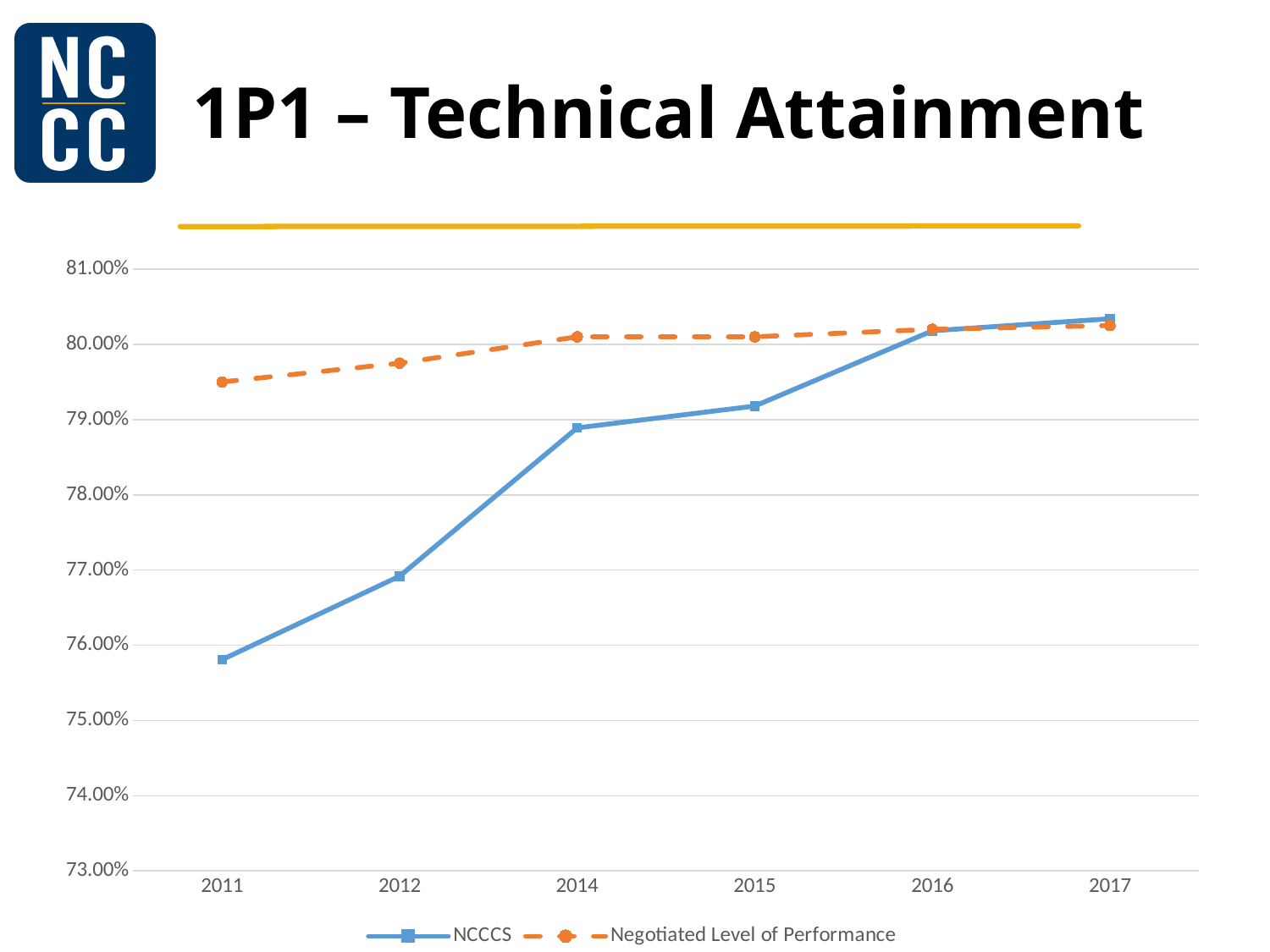
In which year is the Negotiated Level of Performance value lowest? 2011 Is the NCCCS value for 2011 greater or less than 77.00%? less What kind of chart is shown on the slide? line chart How many years are shown on the x axis? 6 Does the NCCCS series rise or fall from 2011 to 2017? rise How many series does the legend list? 2 Which series is drawn with a dashed orange line? Negotiated Level of Performance In 2014, which series has the higher value, NCCCS or Negotiated Level of Performance? Negotiated Level of Performance Is the Negotiated Level of Performance value for 2011 greater or less than 80.00%? less In which year is the NCCCS value lowest? 2011 What is the title of the slide containing the chart? 1P1 – Technical Attainment